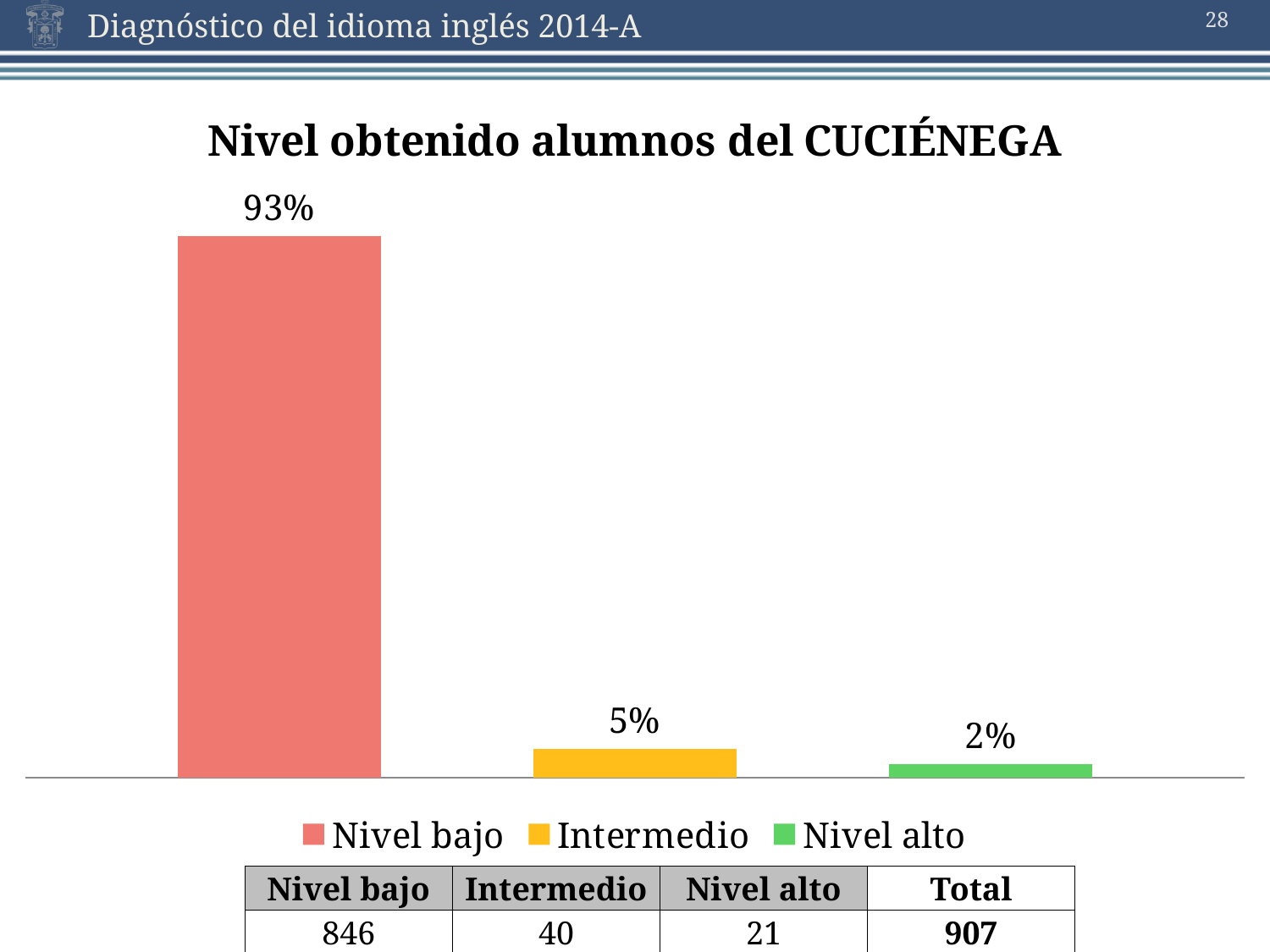
Which level has the lowest percentage? Nivel alto What is the difference in percentage points between Nivel bajo and Intermedio? 88 How many levels are plotted in the chart? 3 Which is larger, the percentage for Intermedio or for Nivel alto? Intermedio What percentage is shown for Intermedio? 5% What kind of chart is shown on the slide? Bar chart What is the difference in percentage points between Intermedio and Nivel alto? 3 How many entries does the legend list? 3 What percentage is shown for Nivel alto? 2% What percentage is shown for Nivel bajo? 93% What is the title of the chart? Nivel obtenido alumnos del CUCIÉNEGA Which level has the highest percentage? Nivel bajo